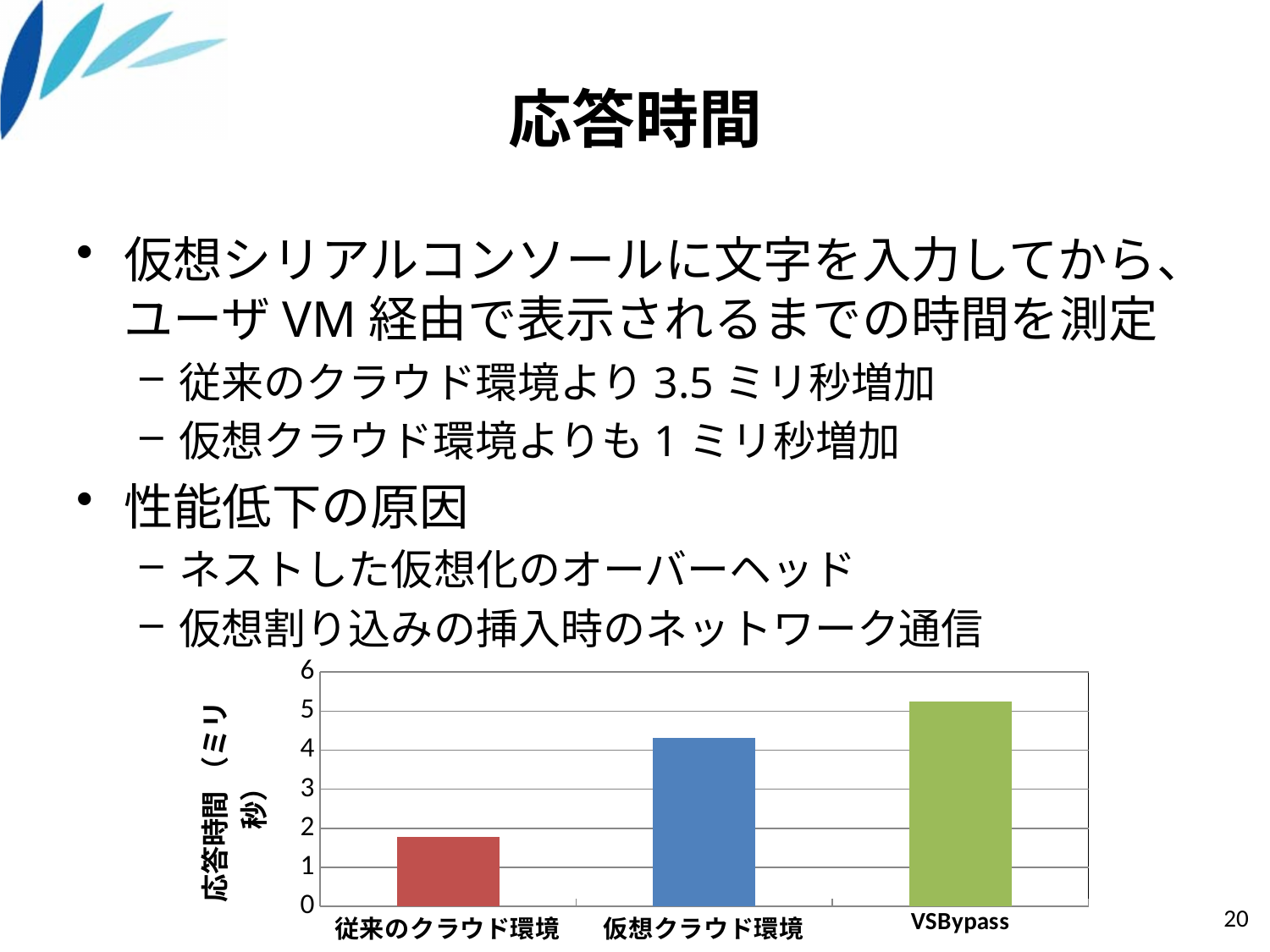
What kind of chart is shown on the slide? bar chart Which category has the lowest response time in the chart? 従来のクラウド環境 Do the bar values rise or fall from left to right along the x axis? rise Is the value for 仮想クラウド環境 greater or less than 4? greater Which has a larger value in the chart, 仮想クラウド環境 or VSBypass? VSBypass What is the maximum value shown on the vertical axis of the chart? 6 Which category has the highest response time in the chart? VSBypass Which has a larger value in the chart, 従来のクラウド環境 or 仮想クラウド環境? 仮想クラウド環境 Is the value for VSBypass greater or less than 5? greater Is the value for 従来のクラウド環境 greater or less than 2? less What is the label of the vertical axis of the chart? 応答時間（ミリ秒） How many categories are plotted on the x axis of the chart? 3